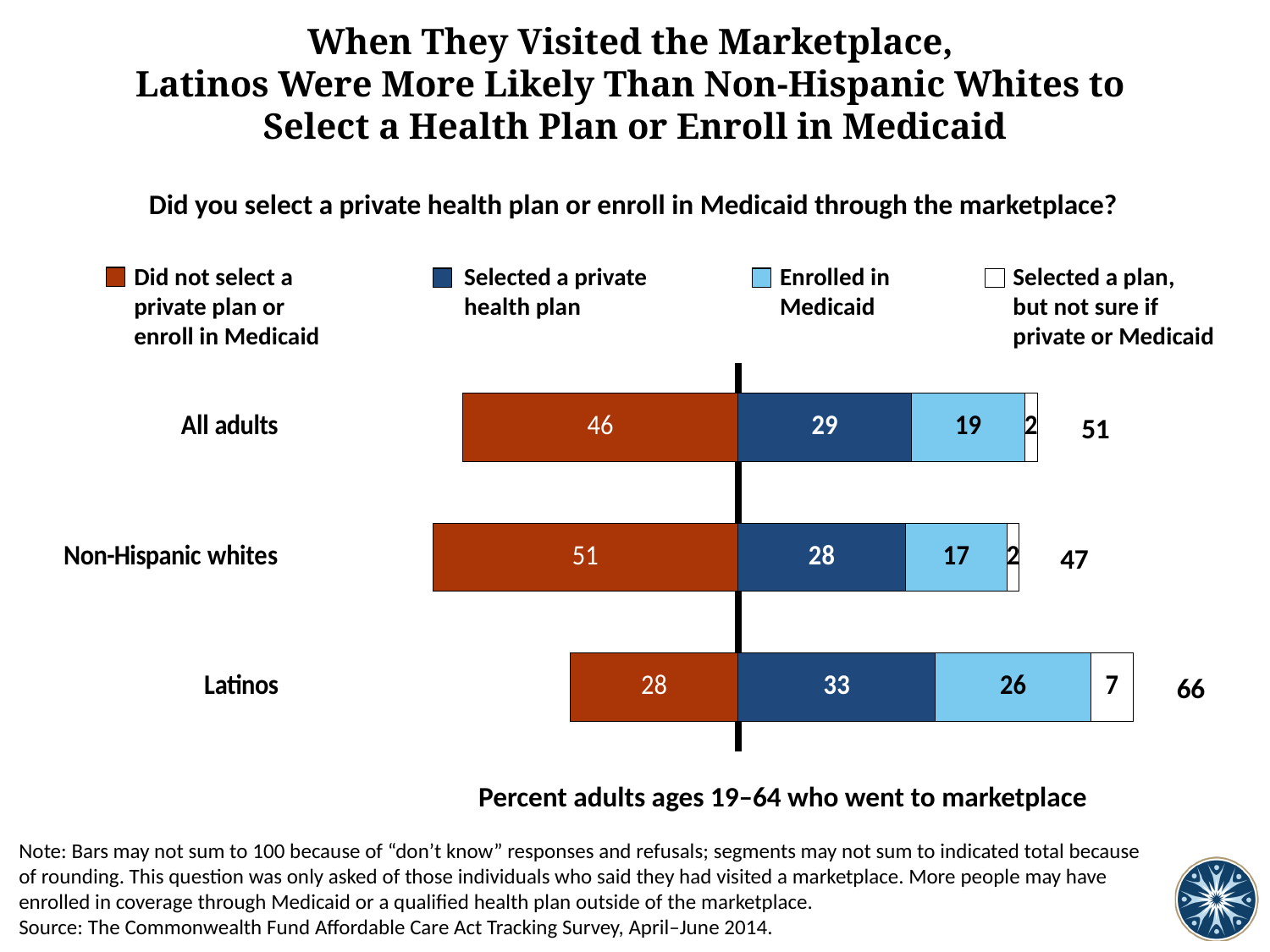
What kind of chart is shown on the slide? Stacked bar chart What total is shown to the right of the Latinos bar for those who selected a plan or enrolled in Medicaid? 66 What percentage of all adults enrolled in Medicaid? 19 Which group has the lowest percentage that did not select a private plan or enroll in Medicaid? Latinos What percentage of Non-Hispanic whites did not select a private plan or enroll in Medicaid? 51 What percentage of Latinos selected a private health plan? 33 How many groups are shown in the chart? 3 What percentage of Latinos selected a plan but were not sure if it was private or Medicaid? 7 Which is larger: the percentage of Latinos who enrolled in Medicaid or the percentage of Non-Hispanic whites who enrolled in Medicaid? Latinos Which group has the highest percentage enrolled in Medicaid? Latinos What is the difference between the percentage of Non-Hispanic whites and Latinos who did not select a private plan or enroll in Medicaid? 23 How many response categories does the legend list? 4